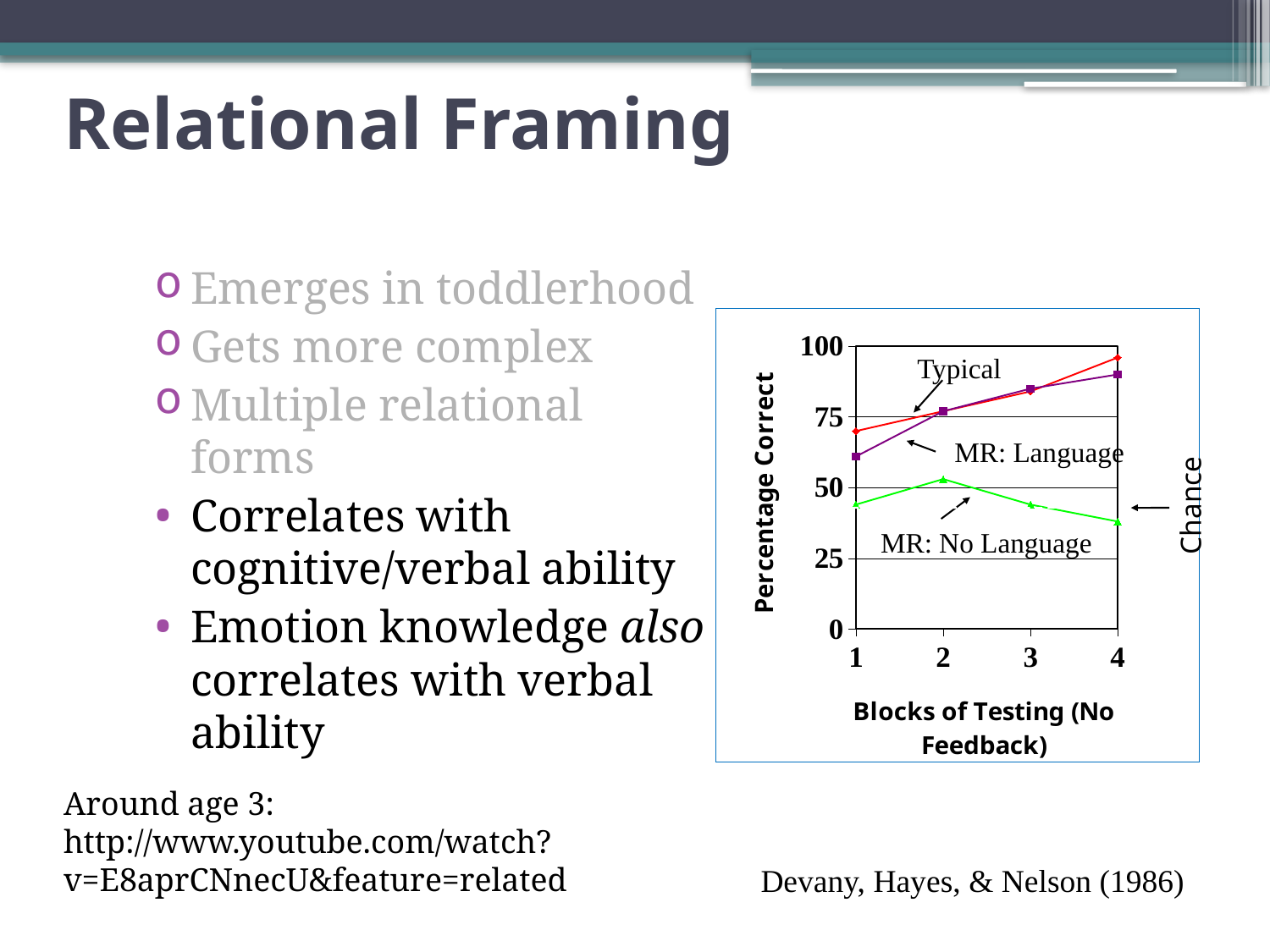
Is the value for MR: No Language at block 4 greater or less than 50? less Which series has the highest value at block 4? Typical Does the Typical line rise or fall from block 1 to block 4? rise Does the MR: No Language line rise or fall from block 2 to block 4? fall What is the title of the x axis? Blocks of Testing (No Feedback) Is the value for Typical at block 4 greater or less than 75? greater How many labelled lines (series) does the chart show? 3 How many blocks of testing are plotted along the x axis? 4 Which series has the lowest value at block 1? MR: No Language What is the title of the y axis? Percentage Correct Is the value for MR: Language at block 1 greater or less than 50? greater What kind of chart is shown on the slide? line chart